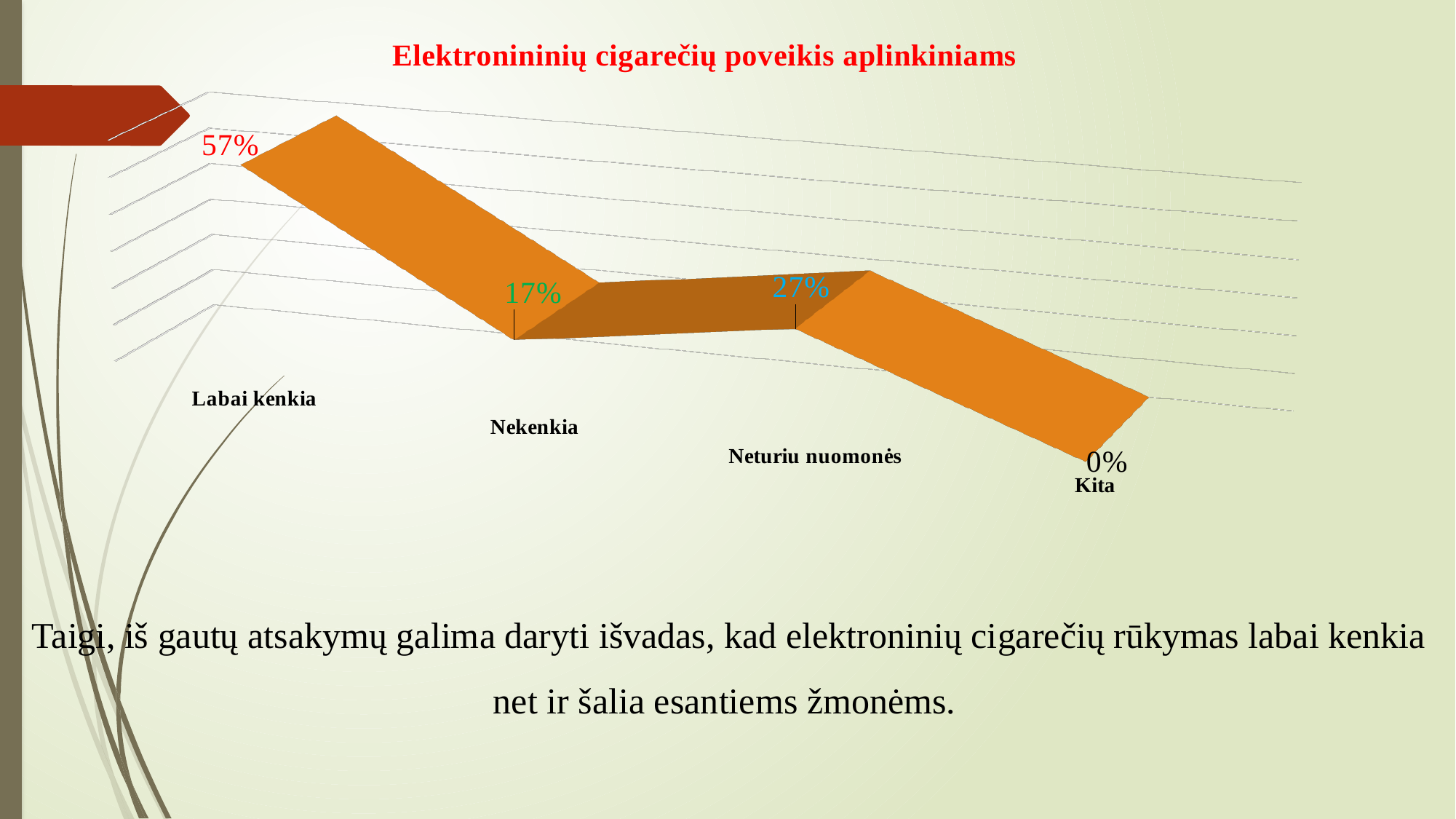
Which is larger, the value for Nekenkia or the value for Neturiu nuomonės? Neturiu nuomonės What is the difference between the values for Labai kenkia and Neturiu nuomonės? 30% Which category has the lowest value? Kita What is the value for Nekenkia? 17% What is the value for Labai kenkia? 57% What kind of chart is shown on the slide? line chart What is the value for Neturiu nuomonės? 27% What is the difference between the values for Neturiu nuomonės and Nekenkia? 10% What is the title of the chart? Elektronininių cigarečių poveikis aplinkiniams How many categories are shown on the chart? 4 Which category has the highest value? Labai kenkia What is the value for Kita? 0%